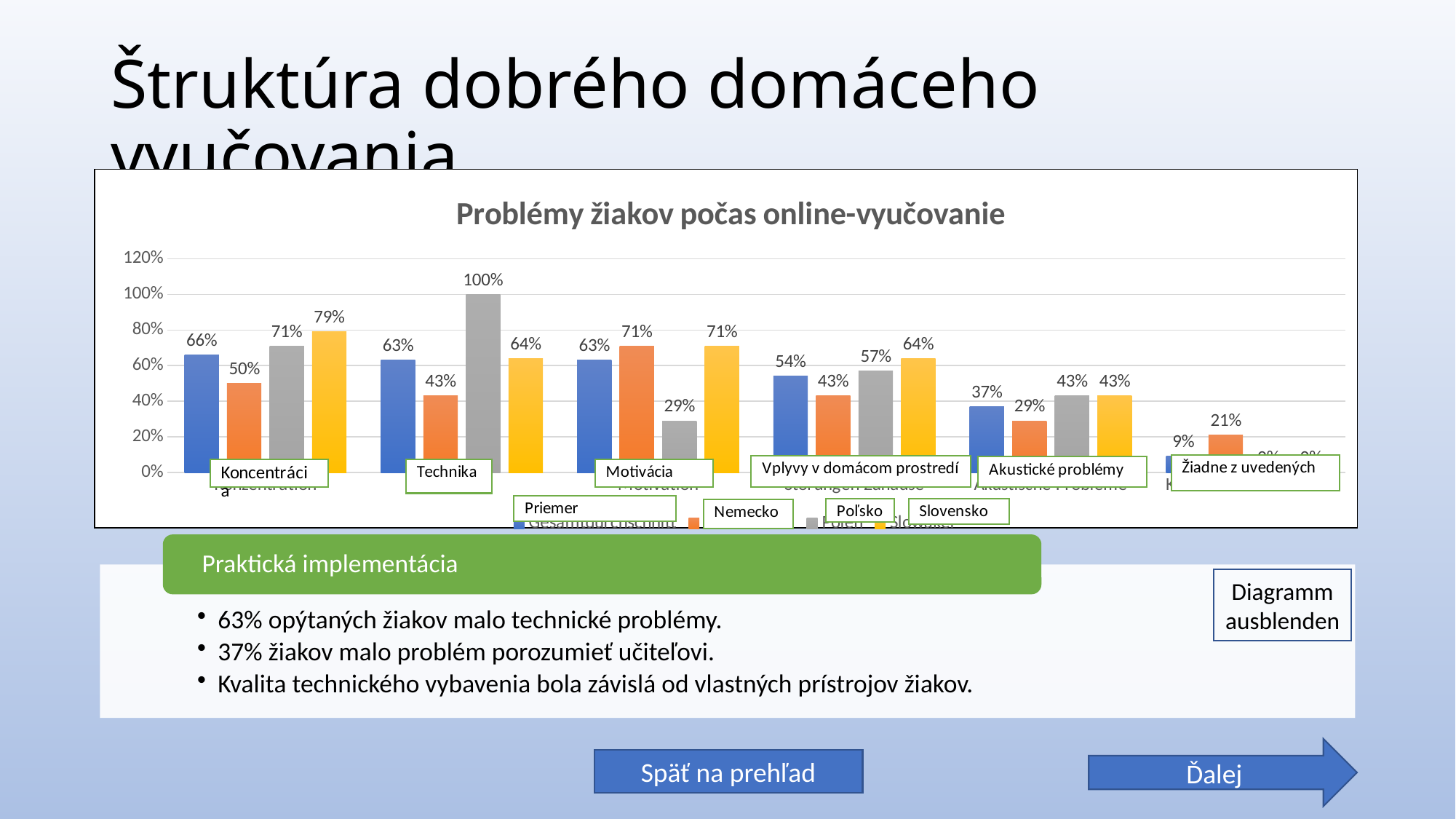
What is the value for Nemecko in the Motivácia category? 71% How many series does the legend list? 4 How many categories are shown on the x axis? 6 Which series has the highest value in the Technika category? Poľsko What is the value for Slovensko in the Koncentrácia category? 79% What is the difference between the Slovensko and Nemecko values in the Vplyvy v domácom prostredí category? 21% Which series has the lowest value in the Motivácia category? Poľsko What is the value for Priemer in the Akustické problémy category? 37% What is the title of the chart? Problémy žiakov počas online-vyučovanie What is the value for Poľsko in the Technika category? 100% Which is larger: the Priemer value for Koncentrácia or the Priemer value for Technika? Koncentrácia What kind of chart is shown on the slide? bar chart